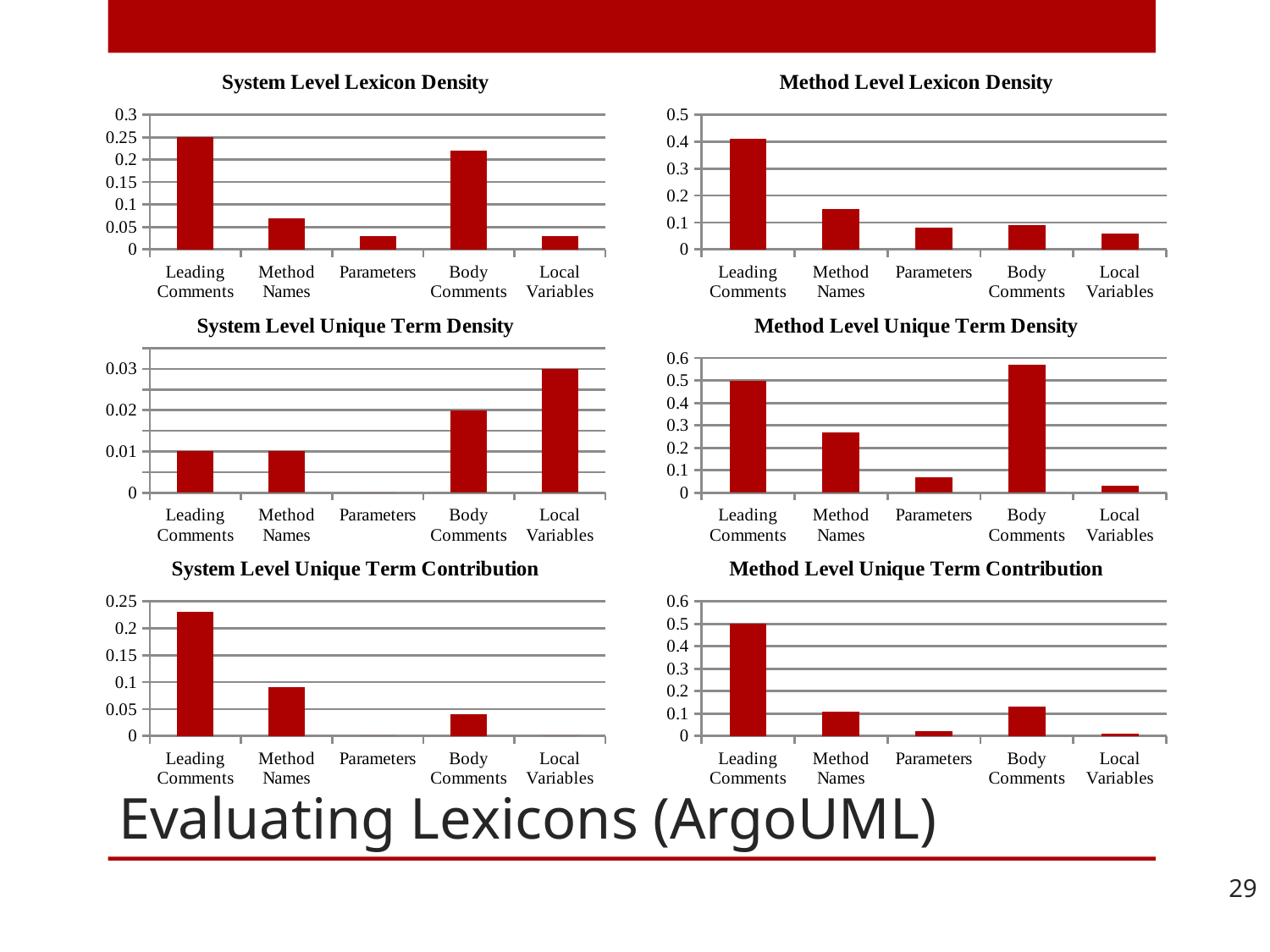
How many categories are shown on the x axis of the Method Level Lexicon Density chart? 5 In the Method Level Unique Term Contribution chart, which is larger, the value for Body Comments or the value for Parameters? Body Comments In the System Level Lexicon Density chart, which is larger, the value for Body Comments or the value for Method Names? Body Comments In the System Level Unique Term Density chart, what is the value for Body Comments? 0.02 In the Method Level Unique Term Density chart, which category has the lowest value? Local Variables In the System Level Unique Term Density chart, what is the value for Local Variables? 0.03 In the System Level Unique Term Density chart, which category has the highest value? Local Variables In the Method Level Unique Term Density chart, which category has the highest value? Body Comments What kind of chart is the System Level Unique Term Contribution chart? Bar chart In the System Level Lexicon Density chart, which category has the highest value? Leading Comments